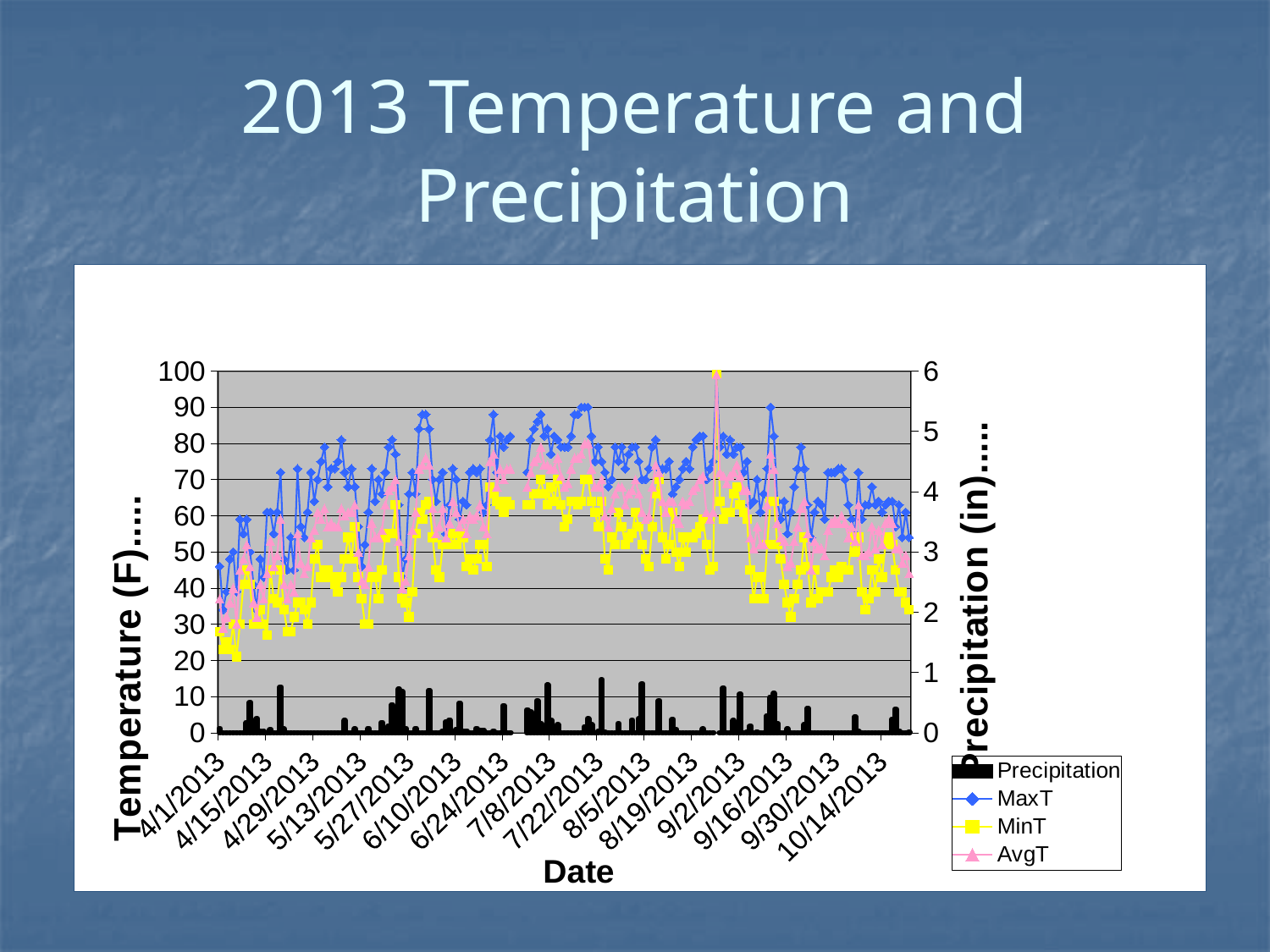
Is the tallest Precipitation bar greater or less than 2 inches? less What is the label of the left vertical axis? Temperature (F) Do the MaxT values generally rise or fall from 4/1/2013 to 7/8/2013? rise Which series is plotted higher throughout the chart, MaxT or MinT? MaxT How many series does the legend list? 4 What kind of chart is this? Combination line and bar chart How many date labels are shown along the x axis? 15 Is the MinT value on 4/1/2013 greater or less than 40? less Which series lies between MaxT and MinT on the chart? AvgT Do the MaxT values generally rise or fall from 8/19/2013 to 10/14/2013? fall Which series is drawn as bars rather than lines? Precipitation Is the MaxT value on 4/1/2013 greater or less than 60? less